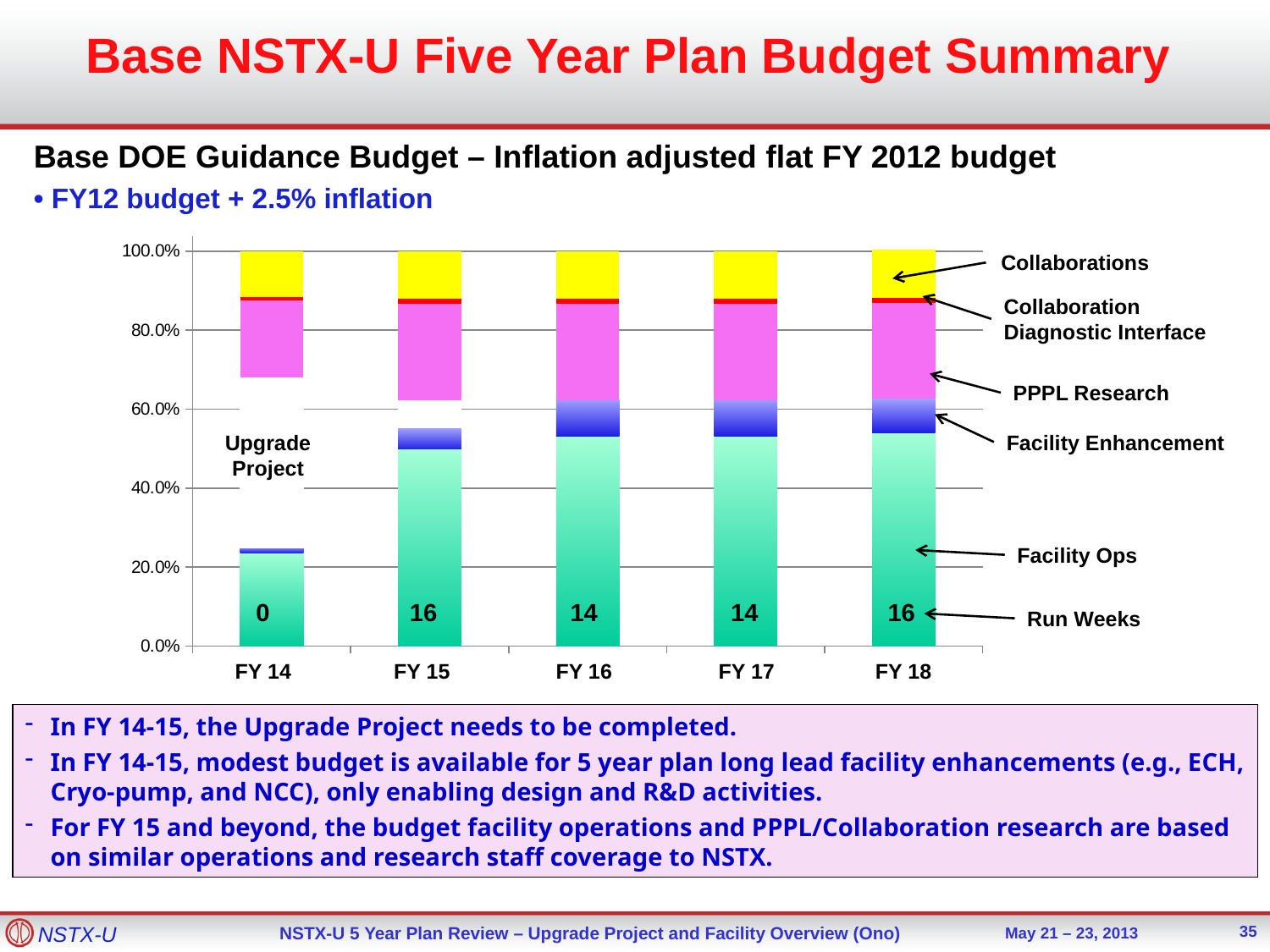
How many run weeks are shown for FY 16? 14 Which fiscal year has the fewest run weeks? FY 14 What kind of chart is shown on the slide? Stacked bar chart Is the Facility Ops share for FY 14 greater or less than 40.0%? less What is the difference in run weeks between FY 15 and FY 17? 2 How many run weeks are shown for FY 15? 16 Which has the larger Facility Ops share, FY 14 or FY 15? FY 15 Is the Facility Ops share for FY 16 greater or less than 40.0%? greater How many fiscal years are shown on the x axis? 5 How many run weeks are shown for FY 14? 0 What is the total height of the FY 15 stacked bar? 100.0% What label is written on the FY 14 bar above the run weeks value? Upgrade Project